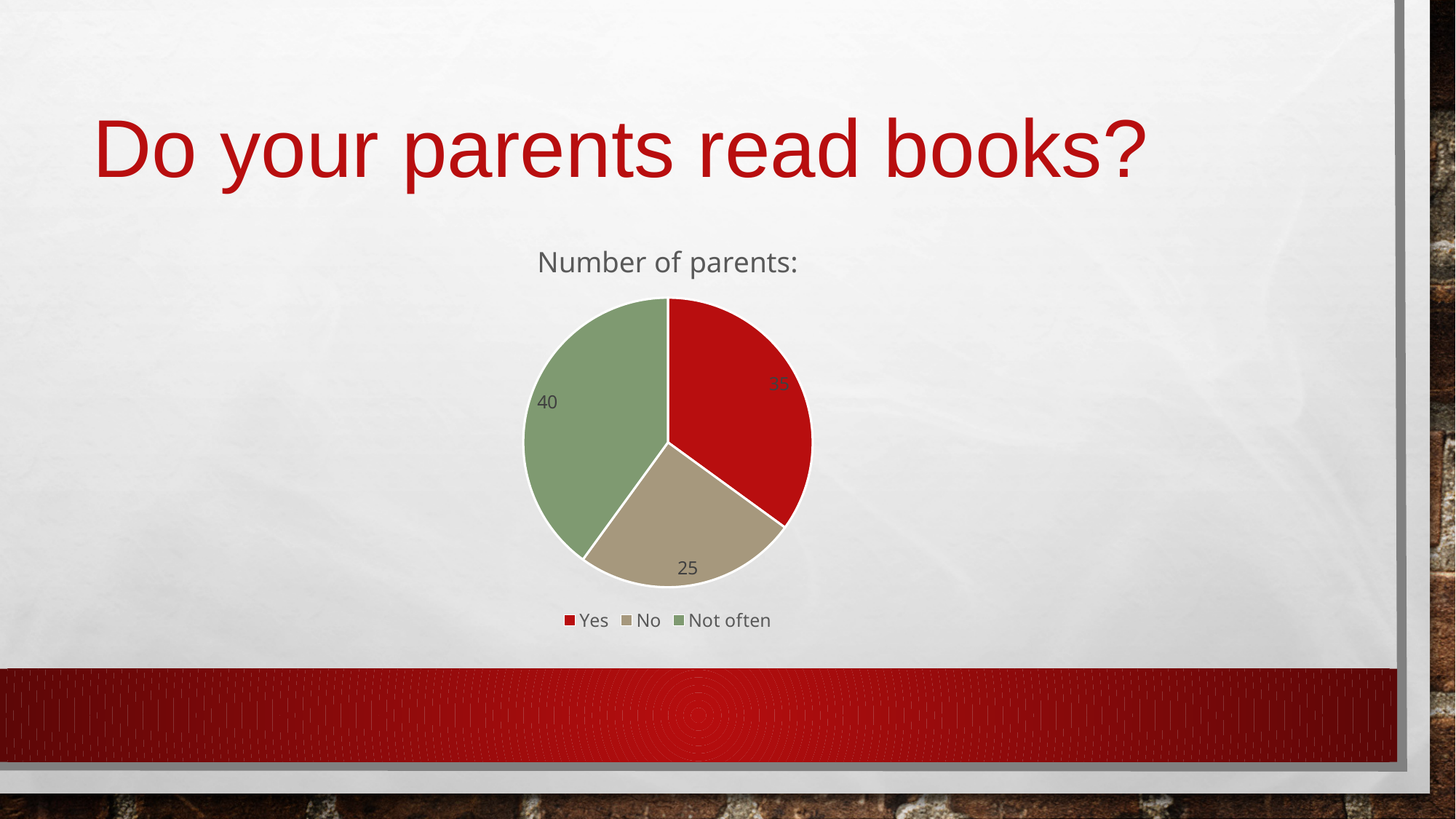
Which answer has the smallest slice of the pie? No What is the chart's title? Number of parents: Which is larger: the value for "Yes" or the value for "No"? Yes Which answer has the largest slice of the pie? Not often How many parents answered "No"? 25 How many categories does the pie chart have? 3 How many parents answered "Not often"? 40 What is the total number of parents across all three slices? 100 How many parents answered "Yes"? 35 What share of the pie does the "Not often" slice represent? 40% What is the difference between the number of parents who answered "Not often" and those who answered "Yes"? 5 What kind of chart is shown on the slide? pie chart